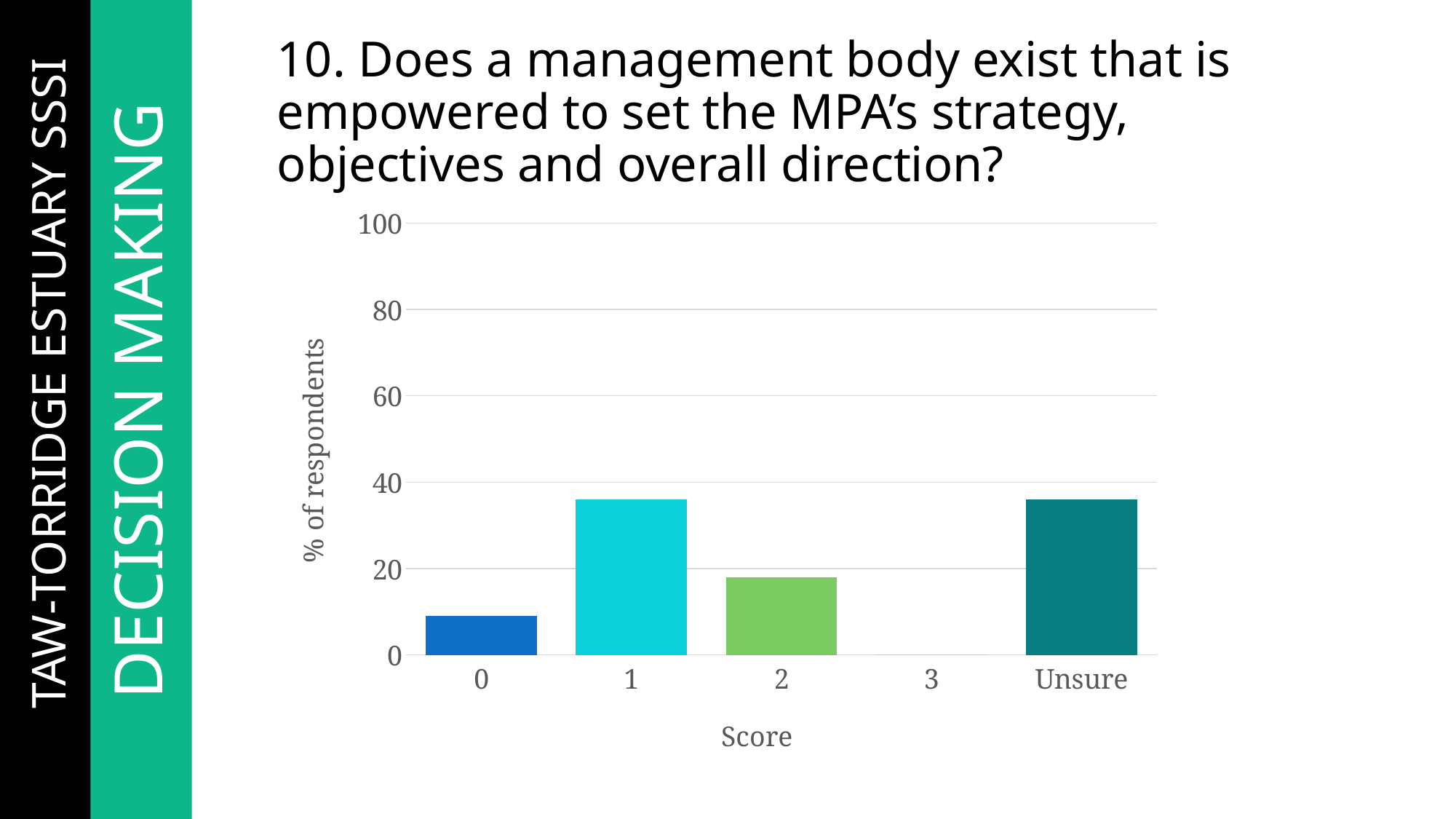
Which score category has the lowest percentage of respondents? 3 What is the value for score 3? 0 Is the value for score 1 greater or less than 40? less Which is larger, the value for score 0 or the value for score 2? score 2 Is the value for score 0 greater or less than 20? less Is the value for Unsure greater or less than 40? less How many score categories are shown on the x axis? 5 What is the label of the y axis? % of respondents What kind of chart is shown on the slide? bar chart Which is larger, the value for score 1 or the value for score 2? score 1